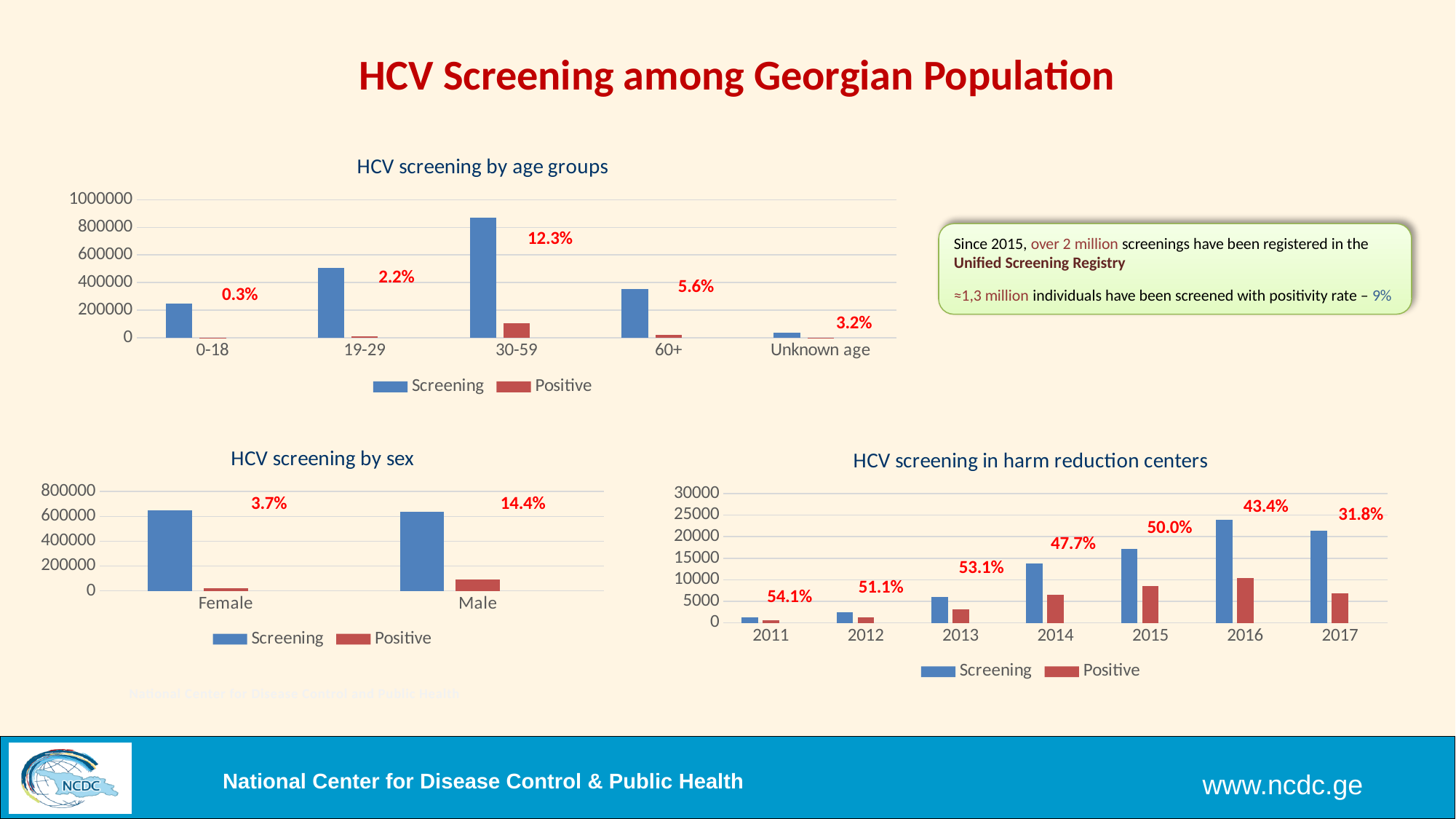
In the 'HCV screening in harm reduction centers' chart, is the Screening value for 2017 greater or less than 20000? greater How many series does the legend list in the 'HCV screening by sex' chart? 2 What type of chart is 'HCV screening in harm reduction centers'? Bar chart In the 'HCV screening in harm reduction centers' chart, which year has the highest Screening bar? 2016 In the 'HCV screening in harm reduction centers' chart, what percentage label is shown for 2015? 50.0% How many age categories are shown in the 'HCV screening by age groups' chart? 5 In the 'HCV screening by age groups' chart, which category has the shortest Screening bar? Unknown age In the 'HCV screening by sex' chart, what percentage label is shown for Male? 14.4% In the 'HCV screening by age groups' chart, what percentage label is shown for the 30-59 age group? 12.3% In the 'HCV screening by age groups' chart, is the Screening value for 19-29 greater or less than 400000? greater In the 'HCV screening by sex' chart, which sex has the larger Positive bar, Female or Male? Male In the 'HCV screening by age groups' chart, which age group has the tallest Screening bar? 30-59